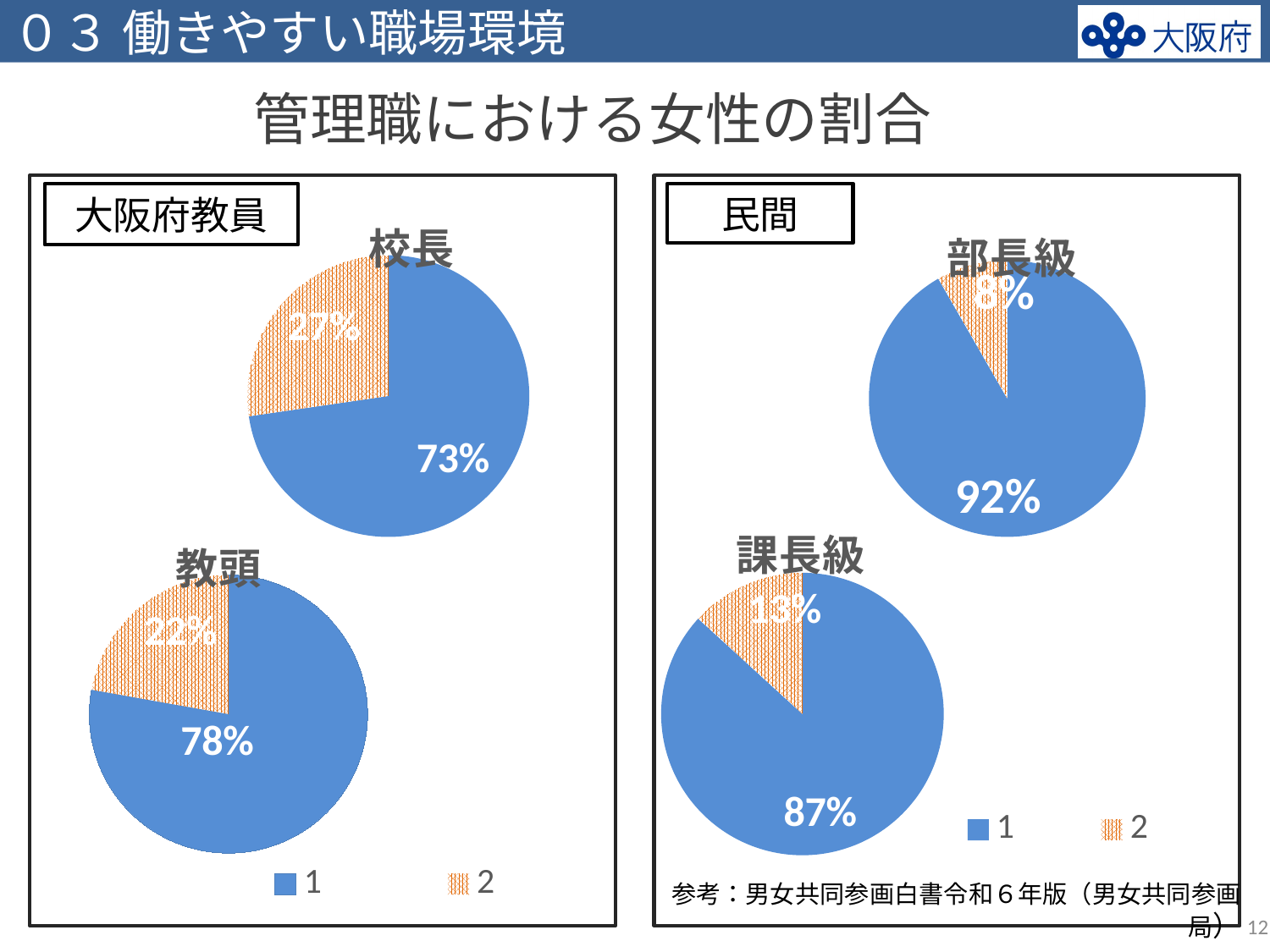
In the 課長級 pie chart, what share does the blue slice (series 1) have? 87% What is the difference between the series 2 share in the 課長級 chart and the series 2 share in the 部長級 chart? 5% In the 教頭 pie chart, what share does the patterned orange slice (series 2) have? 22% How many entries does the legend under the 民間 charts list? 2 In the 教頭 pie chart, what share does the blue slice (series 1) have? 78% In the 部長級 pie chart, what share does the patterned orange slice (series 2) have? 8% In the 校長 pie chart, what share does the patterned orange slice (series 2) have? 27% What kind of chart is used for 部長級? Pie chart In the 課長級 pie chart, what share does the patterned orange slice (series 2) have? 13% In the 校長 pie chart, what share does the blue slice (series 1) have? 73% Which is larger: the series 2 share in the 校長 chart or the series 2 share in the 教頭 chart? 校長 In the 部長級 pie chart, what share does the blue slice (series 1) have? 92%